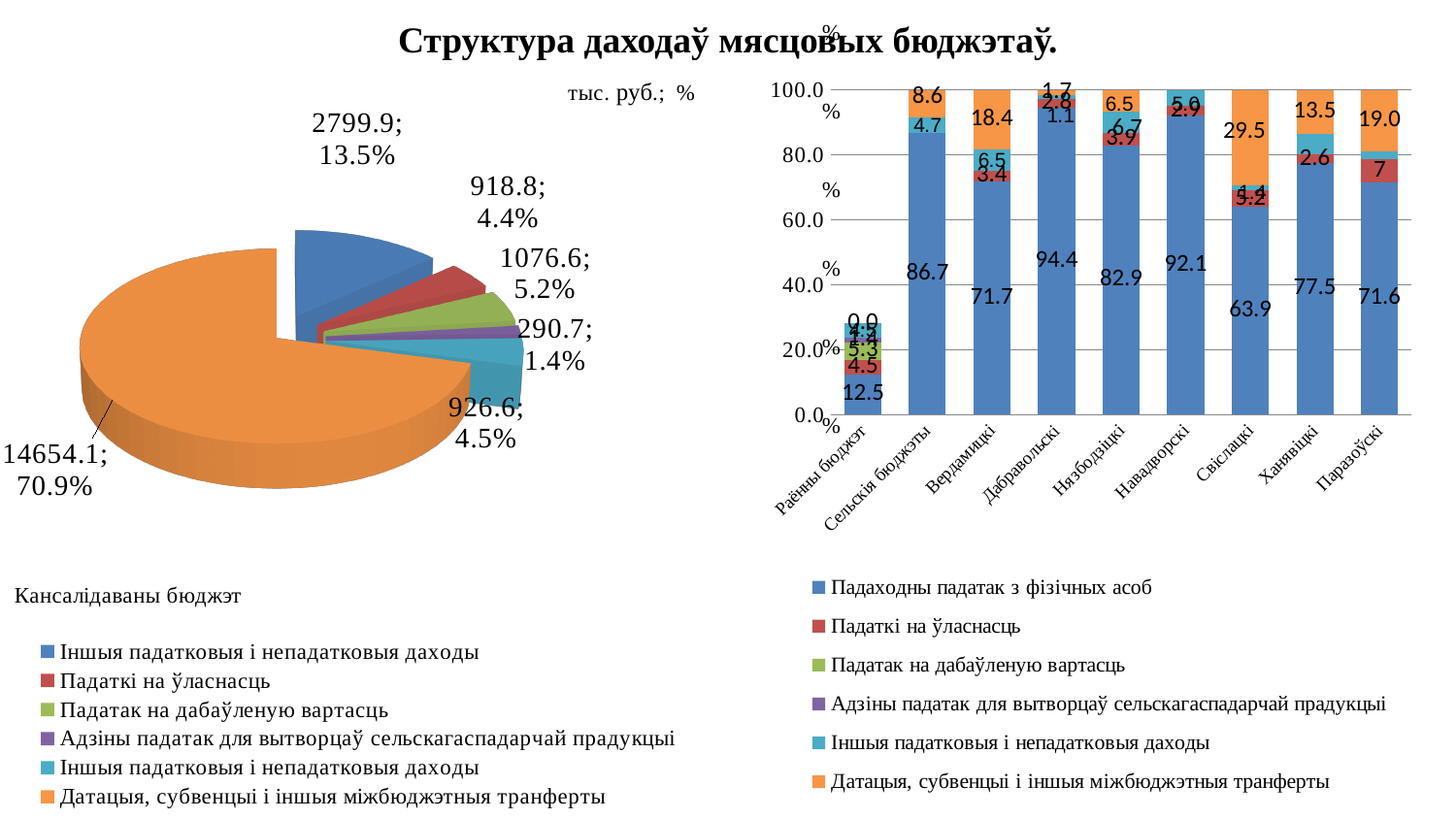
In the bar chart on the right, how many budget categories are shown on the x axis? 9 In the bar chart on the right, what is the value of Датацыі, субвенцыі і іншыя міжбюджэтныя трансферты for Свiслацкi? 29.5 In the bar chart on the right, which budget has the lowest value for Падаходны падатак з фізічных асоб? Раённы бюджэт In the bar chart on the right, how many series does the legend list? 6 In the pie chart on the left, which category has the smallest slice? Адзіны падатак для вытворцаў сельскагаспадарчай прадукцыі In the pie chart on the left, what share of the pie does Падаткі на ўласнасць have? 4.4% In the pie chart on the left, what is the difference between the values for Падатак на дабаўленую вартасць and Падаткі на ўласнасць? 157.8 In the pie chart on the left, what value is shown for Датацыі, субвенцыі і іншыя міжбюджэтныя трансферты? 14654.1; 70.9% What kind of chart is the chart on the right of the slide? Stacked bar chart In the bar chart on the right, what is the value of Падаходны падатак з фізічных асоб for Дабравольскi? 94.4 In the pie chart on the left, which category has the largest slice? Датацыі, субвенцыі і іншыя міжбюджэтныя трансферты In the bar chart on the right, which is larger for Падаходны падатак з фізічных асоб: Сельскія бюджэты or Нязбодзiцкi? Сельскія бюджэты